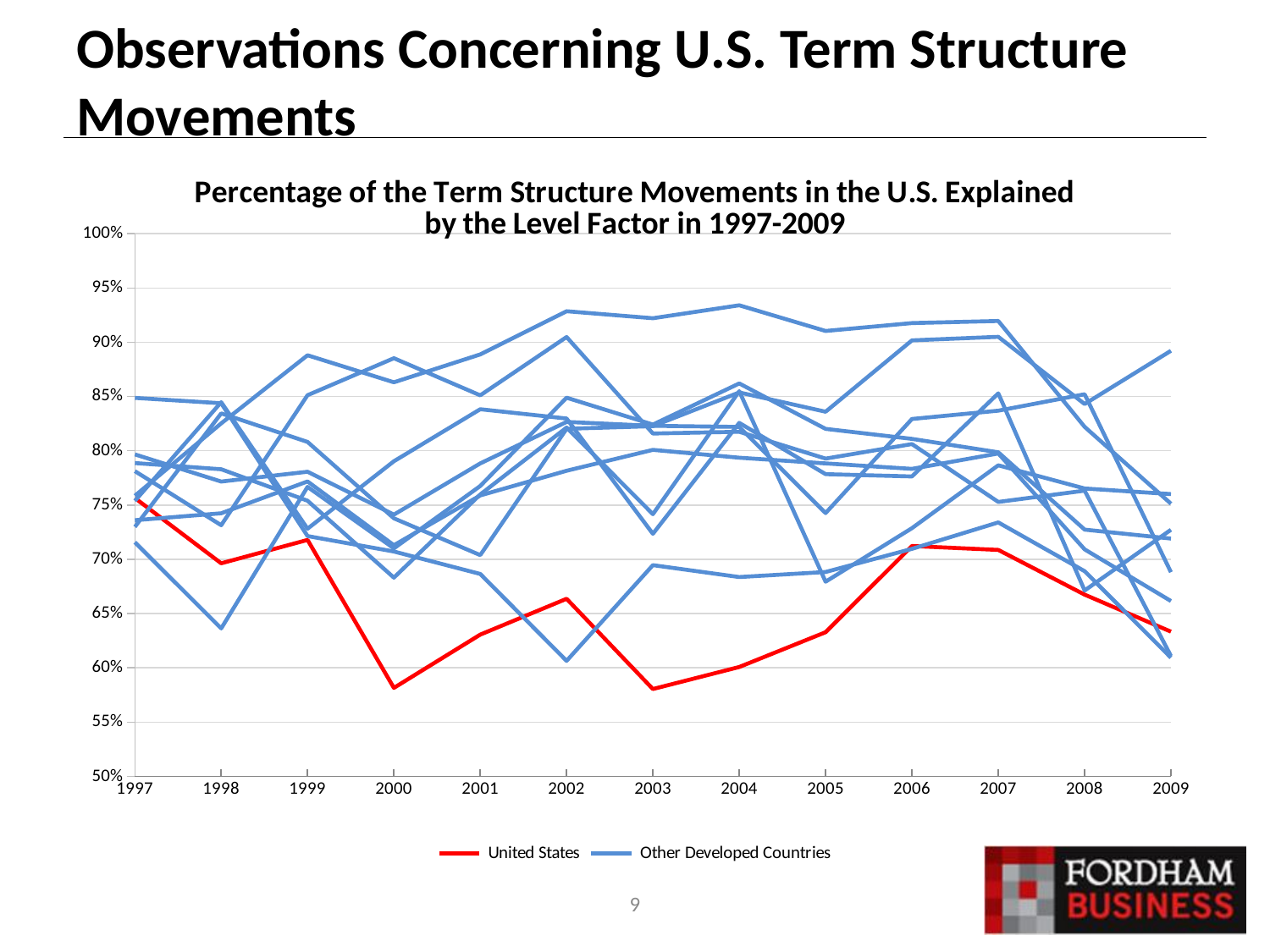
Is the value for United States in 2000 greater or less than 60%? less Is the value for United States in 2009 greater or less than 65%? less In which year does the United States line reach its highest value? 1997 Which is larger for United States: the value in 2000 or the value in 2006? 2006 What kind of chart is shown on the slide? line chart Is the value for United States in 1999 greater or less than 70%? greater How many series does the legend list? 2 How many years are shown along the x axis? 13 What colour is the United States line? red Does the United States line rise or fall from 1999 to 2000? fall What is the title of the chart? Percentage of the Term Structure Movements in the U.S. Explained by the Level Factor in 1997-2009